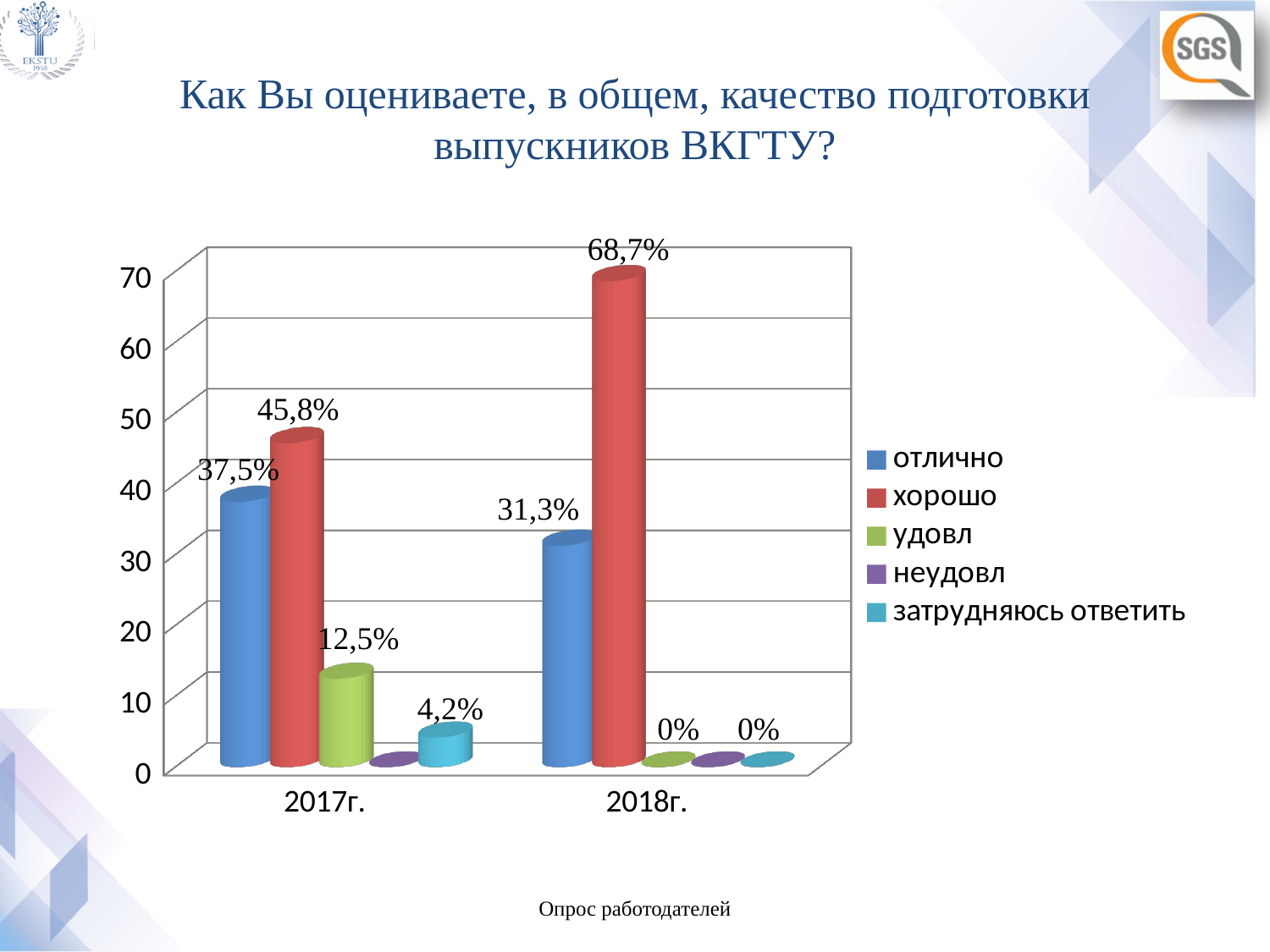
Which is larger: "отлично" in 2017г. or "отлично" in 2018г.? отлично in 2017г. What is the difference between the "хорошо" values for 2018г. and 2017г.? 22,9% What is the value for "хорошо" in 2018г.? 68,7% What is the value for "удовл" in 2017г.? 12,5% How many year categories are shown on the x axis? 2 Which series has the highest value in 2018г.? хорошо What kind of chart is shown on the slide? bar chart What is the value for "затрудняюсь ответить" in 2017г.? 4,2% What is the value for "отлично" in 2017г.? 37,5% How many series does the legend list? 5 Is the value for "отлично" in 2018г. greater or less than 40? less Does the value for "хорошо" rise or fall from 2017г. to 2018г.? rise